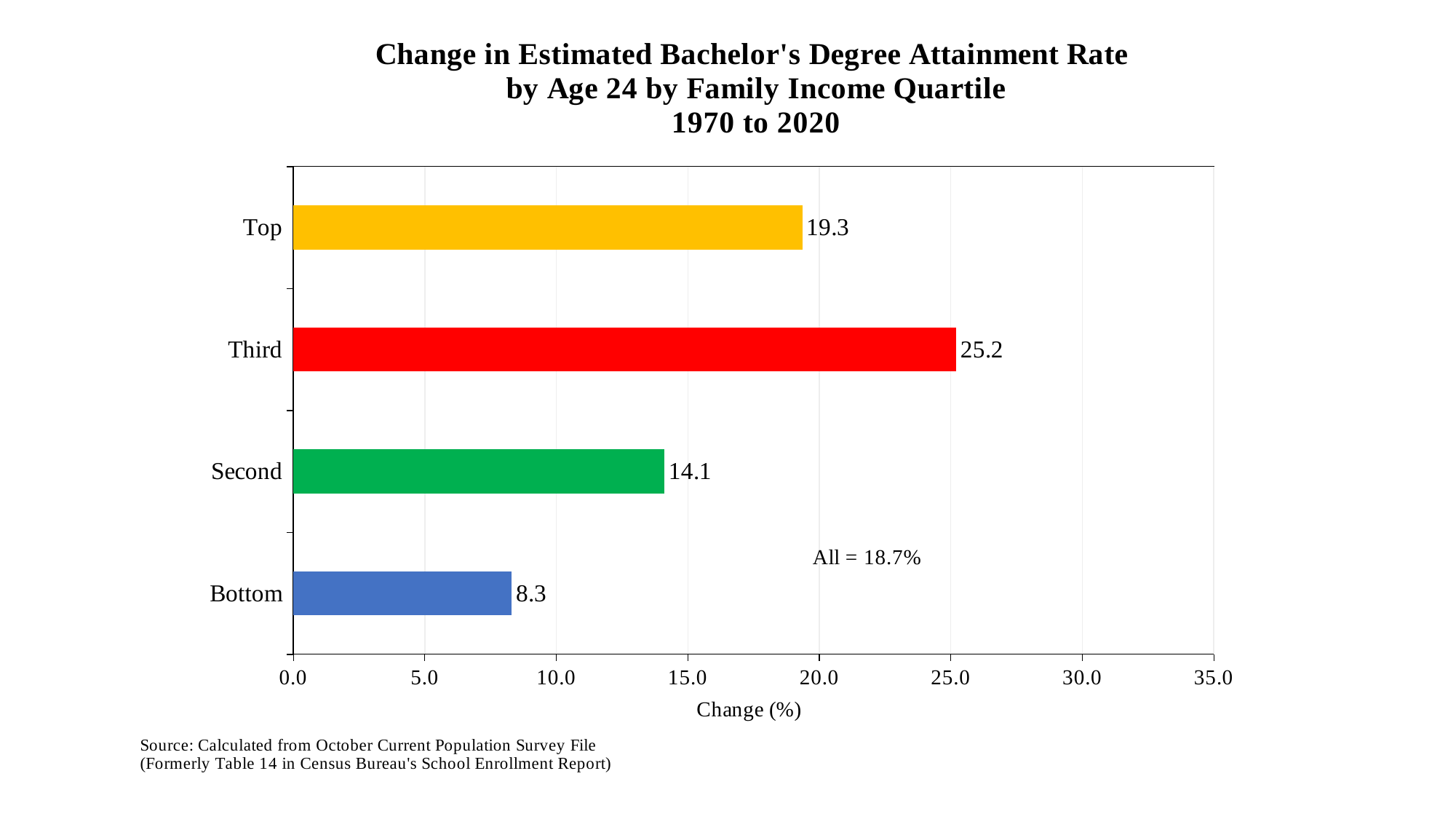
Which family income quartile has the largest change in attainment rate? Third What is the difference between the values for the Second and Bottom quartiles? 5.8 What value is given for All in the annotation on the chart? 18.7% How many family income quartiles are plotted on the chart? 4 What kind of chart is shown on the slide? Bar chart What is the change in estimated bachelor's degree attainment rate for the Top family income quartile? 19.3 Which family income quartile has the smallest change in attainment rate? Bottom Is the value for the Third quartile greater or less than 20.0? greater What is the change in estimated bachelor's degree attainment rate for the Bottom family income quartile? 8.3 What is the difference between the values for the Third and Top quartiles? 5.9 What is the value shown for the Second quartile? 14.1 Which has a larger change in attainment rate, the Top quartile or the Second quartile? Top